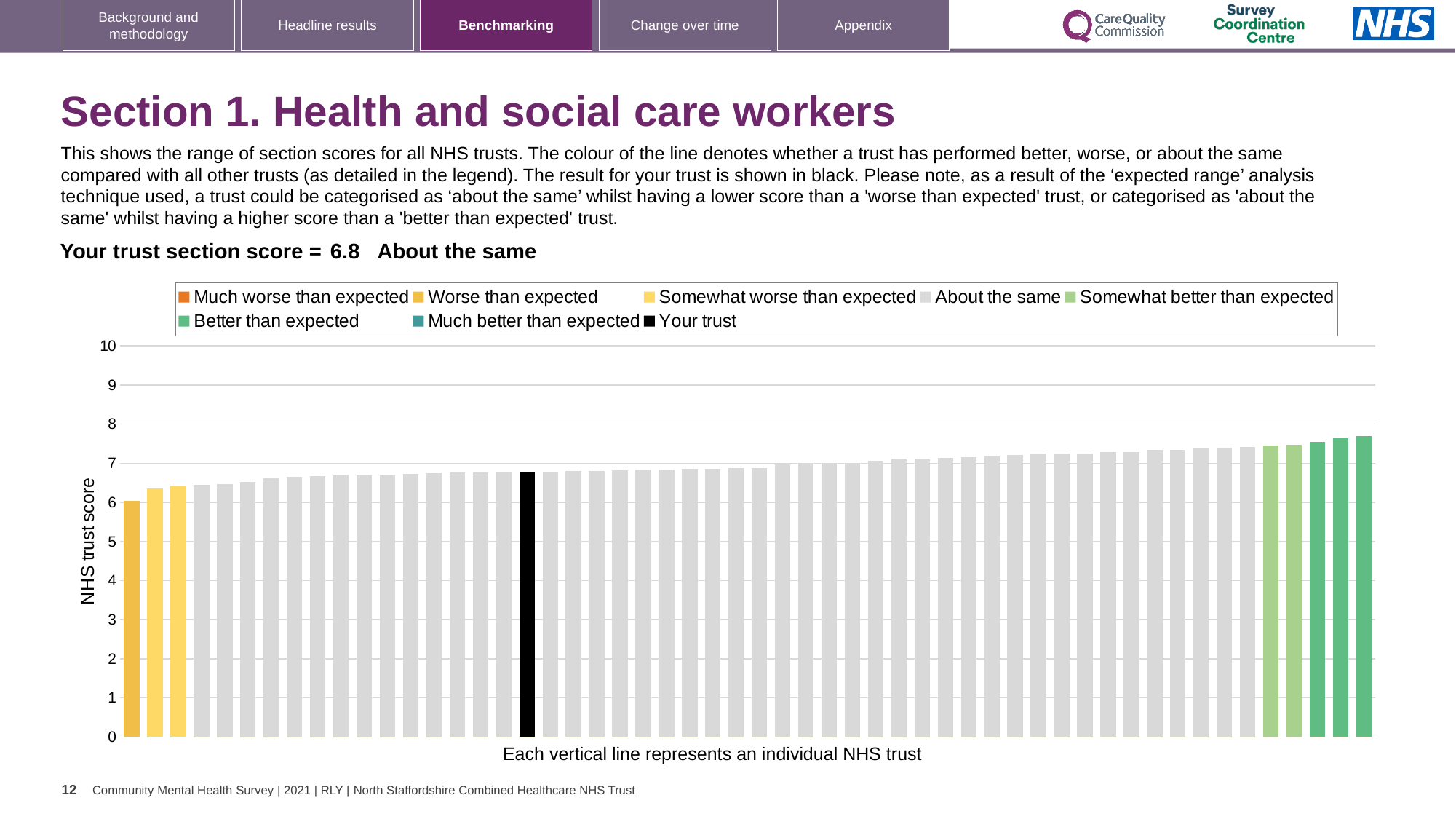
Is the value of the rightmost (highest) bar greater or less than 7? greater Is the value of the rightmost (highest) bar greater or less than 8? less Do the bar values rise or fall from left to right along the x axis? rise How many entries does the chart legend list? 8 Is the value of the 'Your trust' bar greater or less than 7? less What is the trust's section score shown on the slide? 6.8 What is the label on the vertical axis of the chart? NHS trust score What kind of chart is shown on the slide? bar chart What is the highest value shown on the vertical axis? 10 Which benchmarking category is the trust's section score placed in? About the same What colour is the bar representing 'Your trust'? black